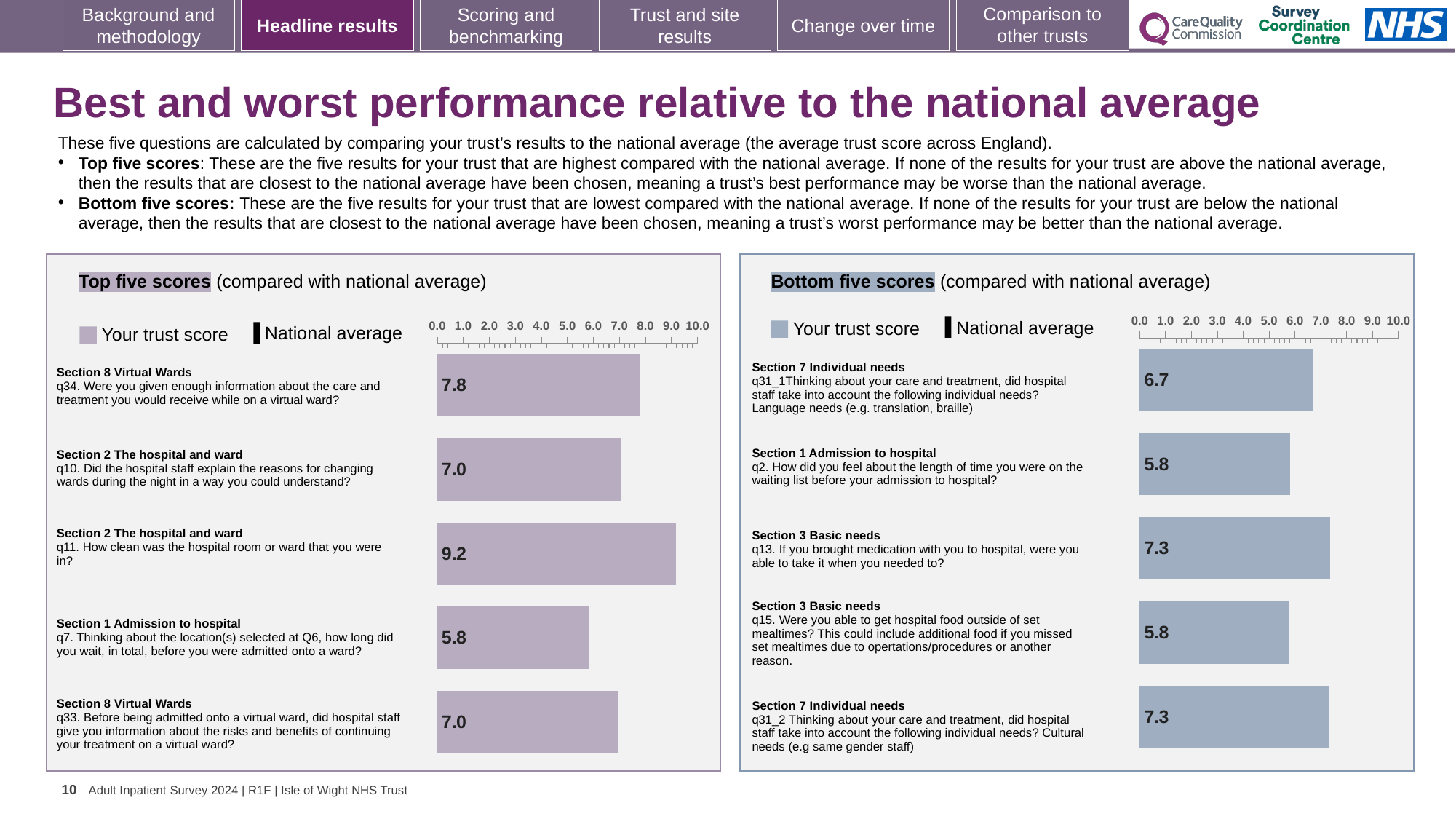
In the Bottom five scores chart, what is the trust score for q31_1 (Language needs)? 6.7 In the Bottom five scores chart, is the trust score for q31_1 greater or less than 5.0? greater In the Bottom five scores chart, what is the trust score for q2 (How did you feel about the length of time you were on the waiting list before your admission to hospital?)? 5.8 In the Top five scores chart, which question has the highest trust score? q11 (How clean was the hospital room or ward) In the Top five scores chart, which question has the lowest trust score? q7 (how long did you wait before being admitted onto a ward) How many series does the legend of the Top five scores chart list? 2 In the Top five scores chart, what is the difference between the trust scores for q11 and q7? 3.4 In the Bottom five scores chart, what is the difference between the trust scores for q13 and q31_1? 0.6 In the Top five scores chart, what is the trust score for q11 (How clean was the hospital room or ward that you were in?)? 9.2 How many bars are shown in the Top five scores chart? 5 In the Top five scores chart, which has the larger trust score: q34 or q10? q34 What type of chart is used in the Bottom five scores panel? Bar chart